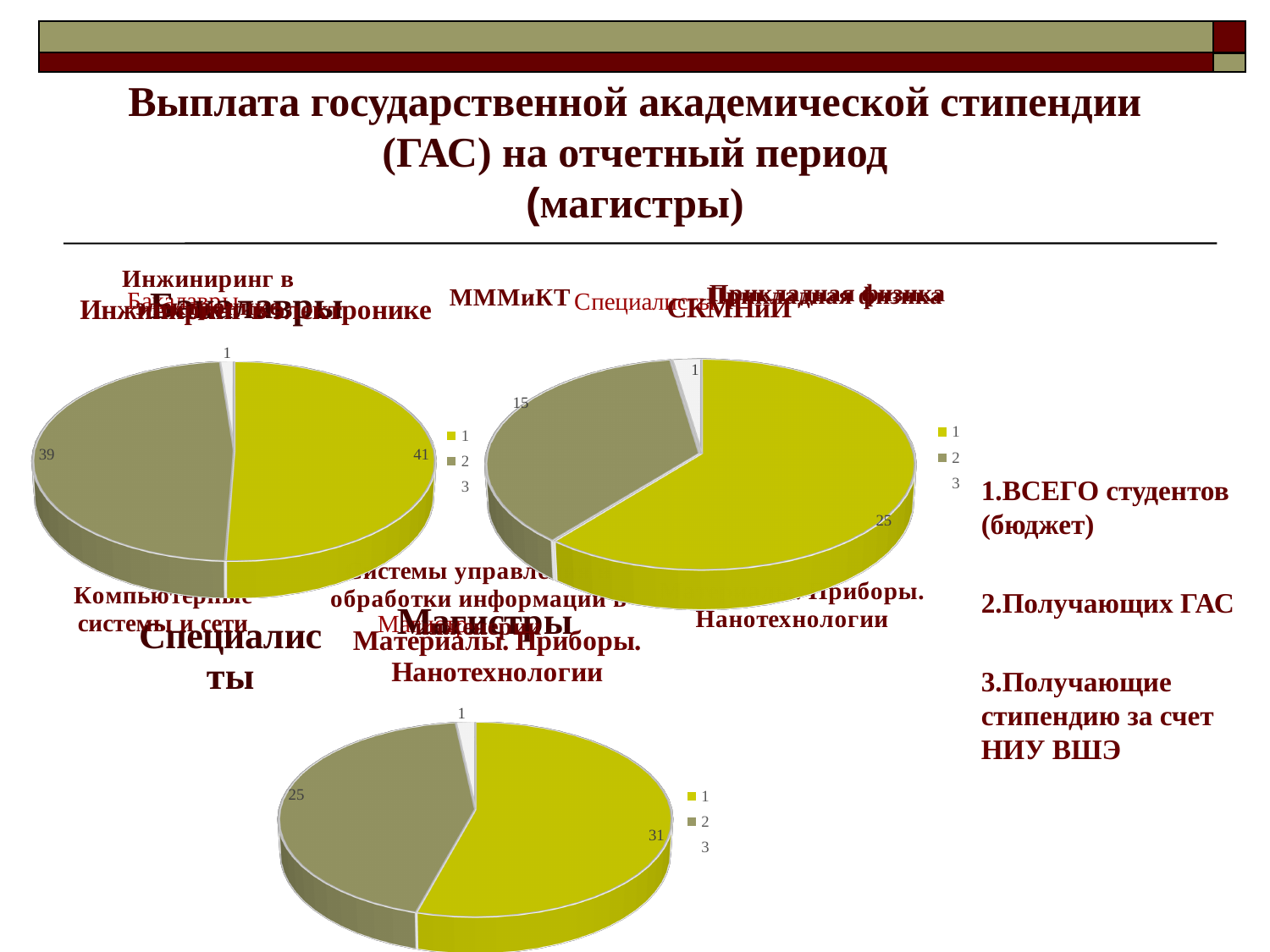
In the bottom pie chart, which is larger, slice 1 or slice 2? 1 In the top-left pie chart, what is the value of slice 2? 39 In the top-right pie chart, what is the difference between slice 1 and slice 2? 10 In the top-left pie chart, which slice is the smallest? 3 In the top-right pie chart, which slice is the largest? 1 What type of chart is the top-left chart on the slide? pie chart In the bottom pie chart, what is the difference between slice 1 and slice 2? 6 In the bottom pie chart, what is the value of slice 1? 31 In the top-left pie chart, what is the value of slice 1? 41 How many entries does the legend of the bottom pie chart list? 3 In the top-right pie chart, what is the value of slice 2? 15 In the top-right pie chart, what is the value of slice 1? 25